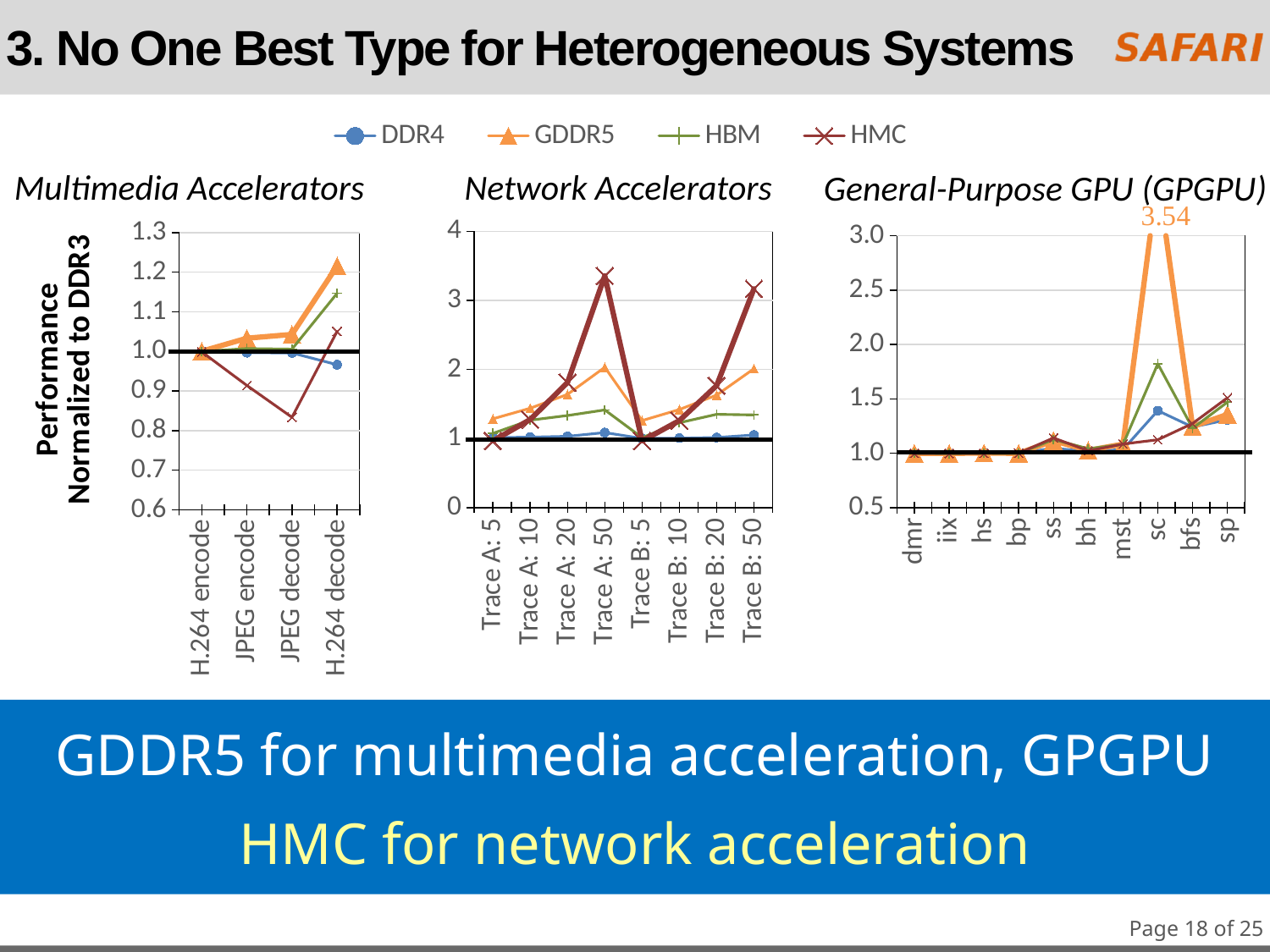
In the Multimedia Accelerators chart, which series has the highest value at H.264 decode? GDDR5 In the Network Accelerators chart, is the value for HMC at Trace A: 50 greater or less than 3? greater How many categories are shown on the x axis of the General-Purpose GPU (GPGPU) chart? 10 How many series does the legend list? 4 How many categories are shown on the x axis of the Network Accelerators chart? 8 In the Network Accelerators chart, which is larger at Trace B: 50, the HMC value or the GDDR5 value? HMC In the General-Purpose GPU (GPGPU) chart, is the value for HBM at sc greater or less than 1.5? greater In the Multimedia Accelerators chart, is the value for HMC at JPEG decode greater or less than 0.9? less In the Network Accelerators chart, which series reaches the highest value at Trace A: 50? HMC What kind of chart is the Multimedia Accelerators chart? Line chart In the General-Purpose GPU (GPGPU) chart, what is the labeled value for GDDR5 at sc? 3.54 In the Multimedia Accelerators chart, which series has the lowest value at JPEG decode? HMC